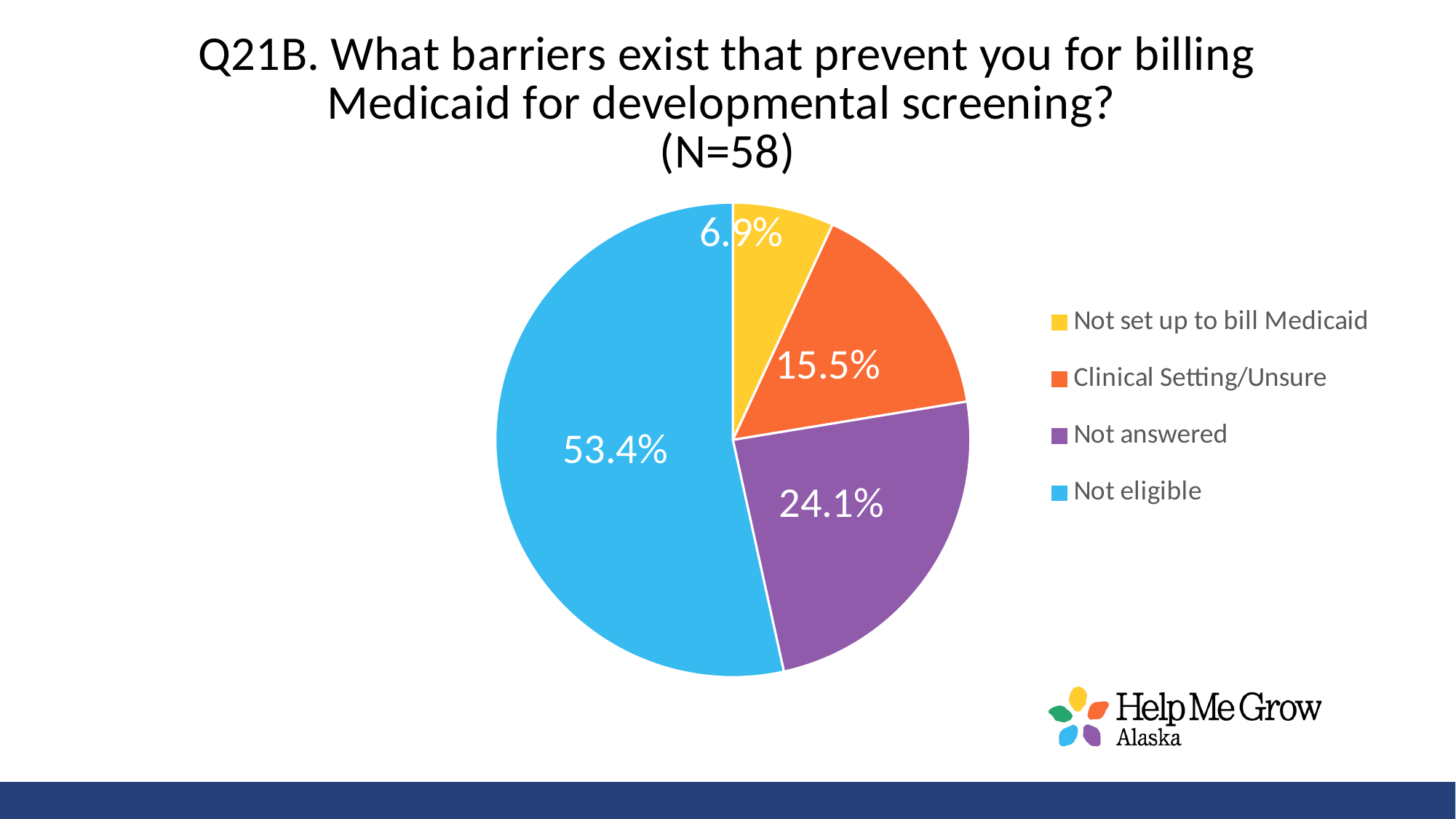
Which category has the largest share of the pie? Not eligible Which is larger, the share for "Clinical Setting/Unsure" or the share for "Not answered"? Not answered What is the difference in percentage points between "Not eligible" and "Not answered"? 29.3 What percentage of respondents answered "Not eligible"? 53.4% Which category has the smallest share of the pie? Not set up to bill Medicaid What percentage of respondents answered "Not set up to bill Medicaid"? 6.9% How many categories does the pie chart show? 4 What kind of chart is shown on the slide? pie chart What colour is the "Not eligible" slice? blue What is the sample size (N) stated in the chart title? 58 What percentage of respondents answered "Clinical Setting/Unsure"? 15.5% What percentage of respondents answered "Not answered"? 24.1%